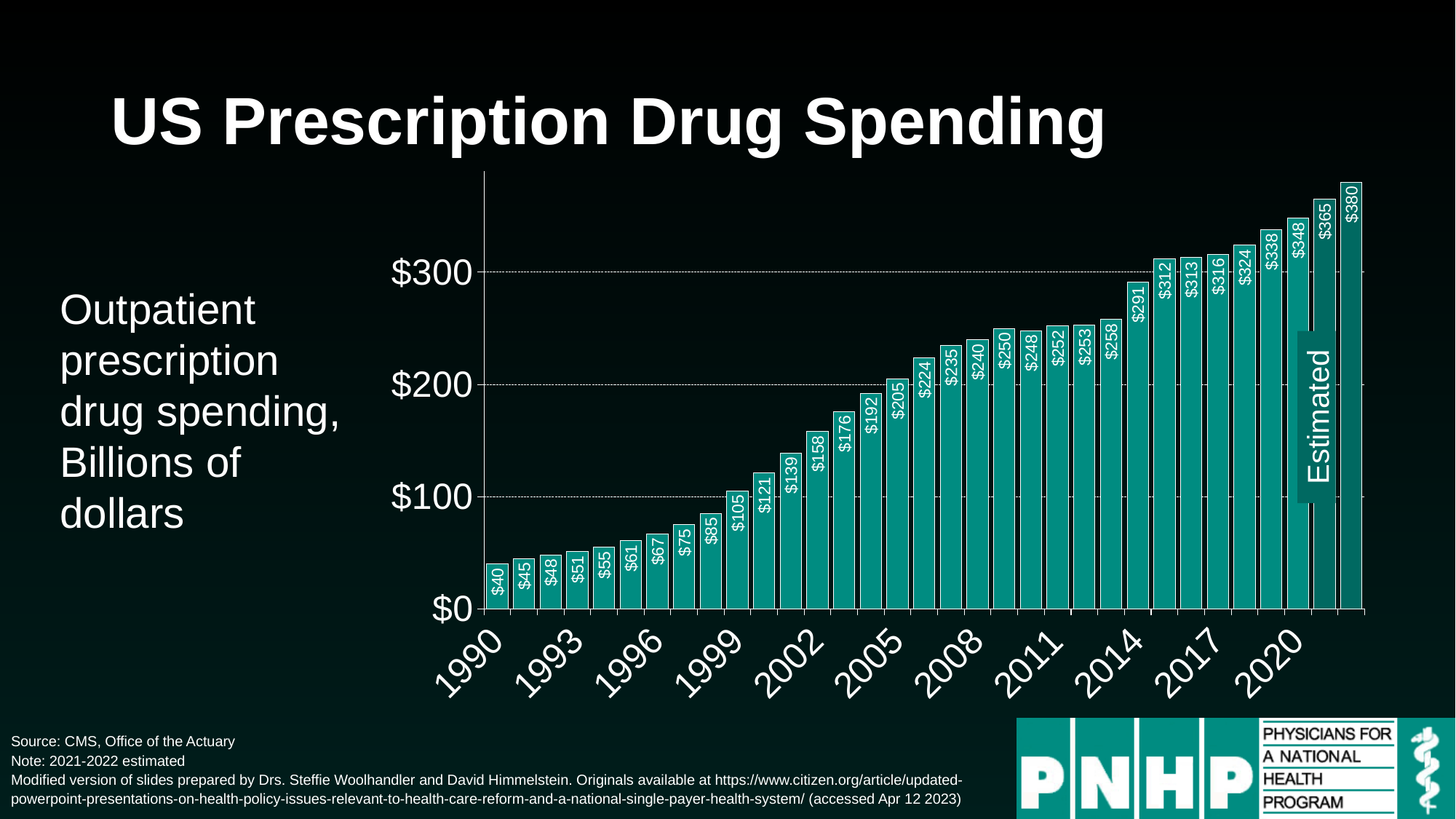
What is the highest value shown on the chart? $380 Which year has the lowest value? 1990 Which is larger, the value for 2011 or the value for 2008? 2011 What is the value for 2014? $291 What is the difference between the values for 2020 and 1990? $308 Do the values generally rise or fall from 1990 to the last bar? rise Is the value for 2017 greater or less than $300? greater What kind of chart is shown? bar chart What is the value for 2008? $240 What is the value for 2020? $348 What is the value for 1990? $40 How many bars are plotted on the chart? 33